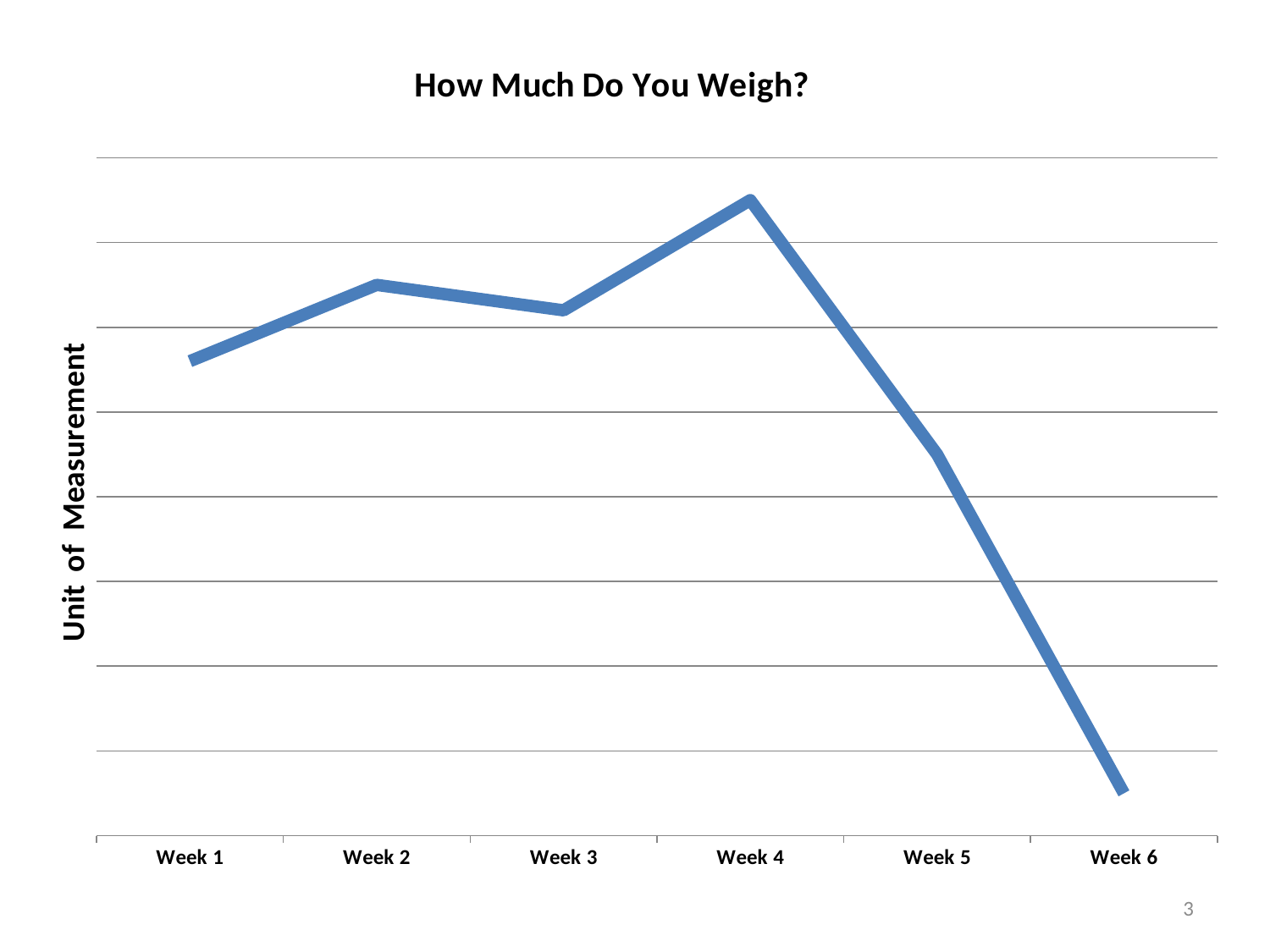
How many weeks are plotted on the x axis? 6 Which is larger, the value for Week 3 or the value for Week 4? Week 4 Which is larger, the value for Week 4 or the value for Week 5? Week 4 Which week has the highest value? Week 4 Which is larger, the value for Week 1 or the value for Week 2? Week 2 What is the title of the chart? How Much Do You Weigh? Do the values rise or fall from Week 1 to Week 2? rise Which week has the lowest value? Week 6 Do the values rise or fall from Week 4 to Week 6? fall What is the label on the vertical axis? Unit of Measurement What kind of chart is shown on the slide? line chart